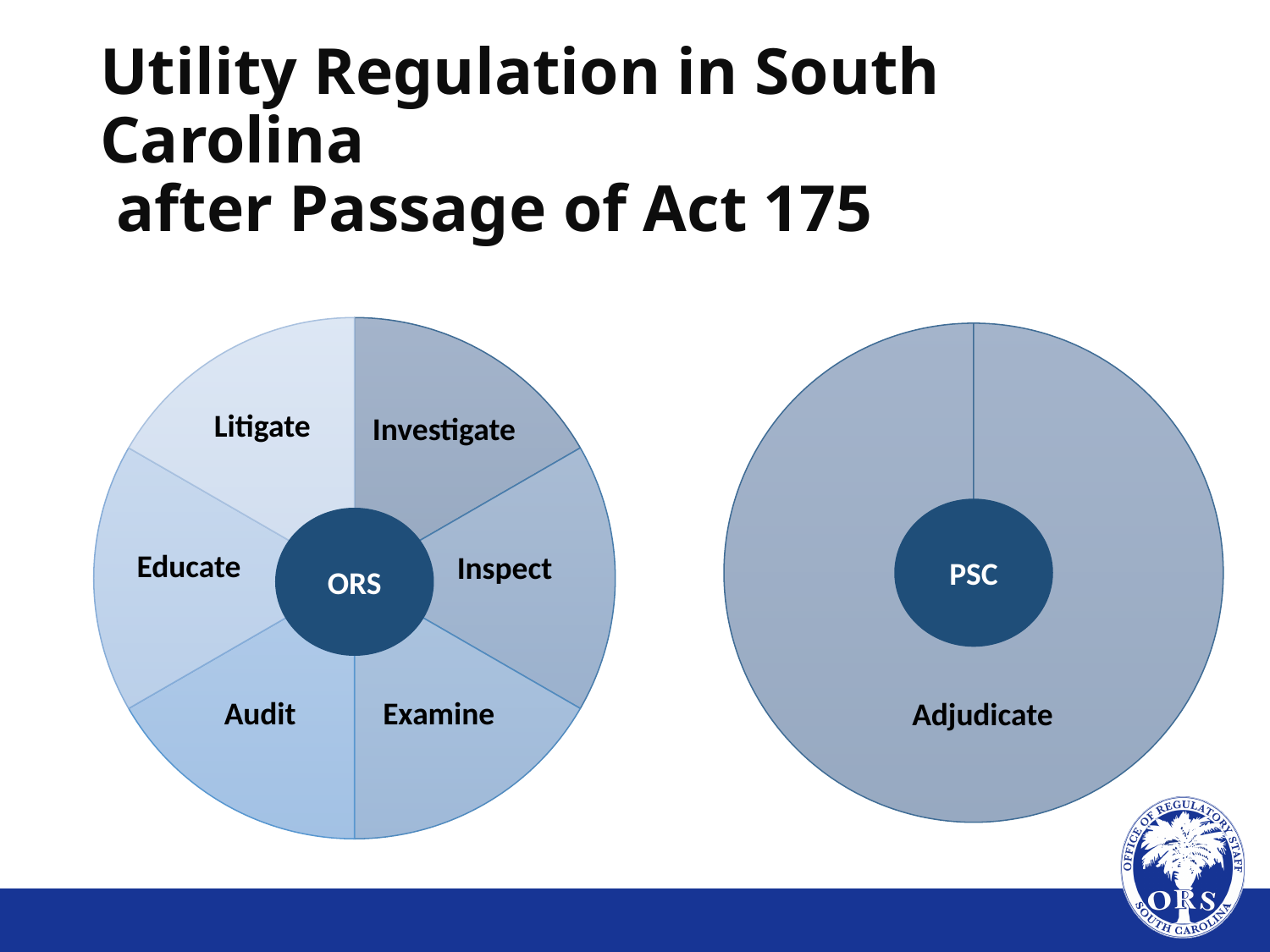
In the left chart labelled ORS, which segment is directly below the Educate segment? Audit How many charts are shown on the slide? 2 What is the label of the only segment in the right chart labelled PSC? Adjudicate What kind of chart is the right chart labelled PSC? Pie chart In the left chart labelled ORS, which segment is directly to the right of the Litigate segment? Investigate What label appears in the centre circle of the left chart? ORS How many segments does the right chart labelled PSC have? 1 What kind of chart is the left chart labelled ORS? Pie chart How many segments does the left chart labelled ORS have? 6 What label appears in the centre circle of the right chart? PSC In the left chart labelled ORS, which segment lies between Investigate and Examine? Inspect Which chart has more segments, the ORS chart on the left or the PSC chart on the right? The ORS chart on the left